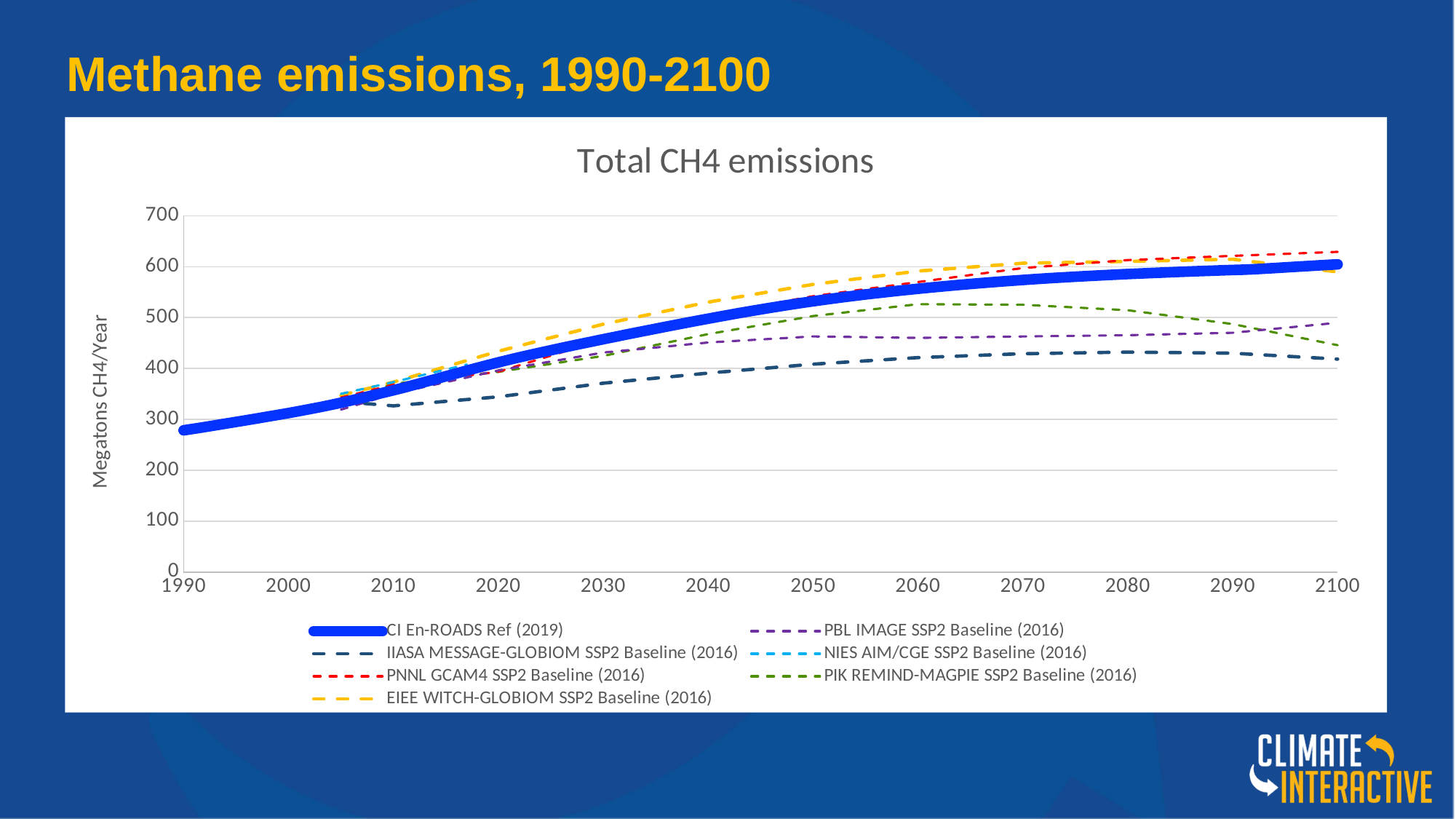
What is the title of the chart? Total CH4 emissions Is the value for CI En-ROADS Ref (2019) in 1990 greater or less than 300? less Does the CI En-ROADS Ref (2019) line rise or fall from 1990 to 2100? rise Which series has the highest value in 2100? PNNL GCAM4 SSP2 Baseline (2016) How many series does the legend list? 7 In 2050, which is higher: CI En-ROADS Ref (2019) or IIASA MESSAGE-GLOBIOM SSP2 Baseline (2016)? CI En-ROADS Ref (2019) What kind of chart is shown on the slide? line chart Is the value for CI En-ROADS Ref (2019) in 2100 greater or less than 500? greater Is the value for IIASA MESSAGE-GLOBIOM SSP2 Baseline (2016) in 2100 greater or less than 500? less What is the label on the vertical axis? Megatons CH4/Year Which series has the lowest value in 2100? IIASA MESSAGE-GLOBIOM SSP2 Baseline (2016) Does the PIK REMIND-MAGPIE SSP2 Baseline (2016) line rise or fall between 2070 and 2100? fall